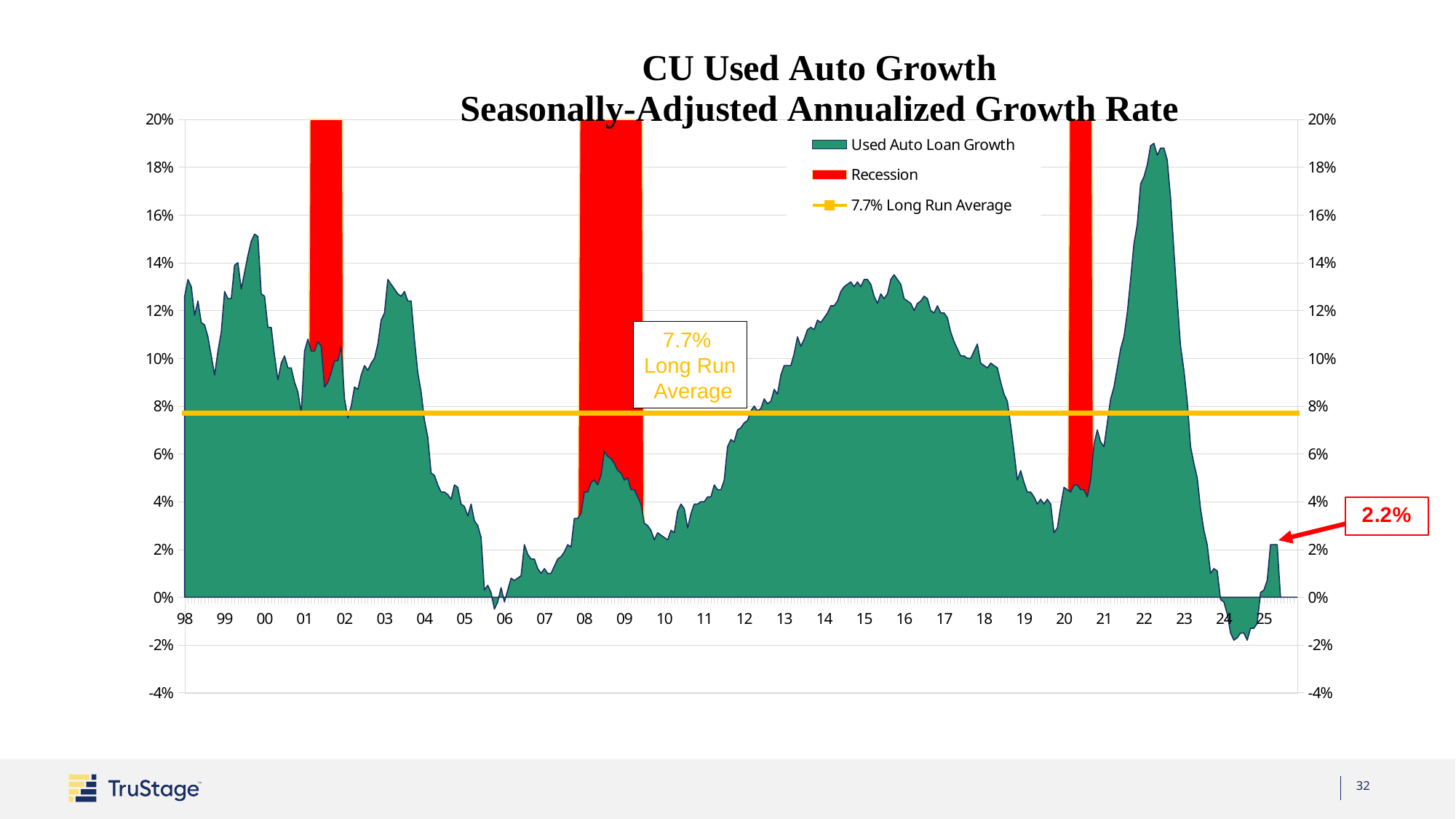
What is the title of the chart? CU Used Auto Growth Seasonally-Adjusted Annualized Growth Rate How many entries does the chart's legend list? 3 How many recession periods are shaded on the chart? 3 Which peak is higher, the one around 2022 or the one around 2000? 2022 What is the most recent used auto loan growth value called out on the chart? 2.2% What is the long run average growth rate shown on the chart? 7.7% What kind of chart is shown on the slide? Area chart Which is larger, the latest value of 2.2% or the 7.7% long run average? 7.7% long run average Does used auto loan growth rise or fall between 2022 and 2024? Fall By how many percentage points is the latest value of 2.2% below the 7.7% long run average? 5.5 percentage points Is the peak used auto loan growth value around 2022 greater or less than 18%? greater Is the used auto loan growth value in 2024 greater or less than 0%? less